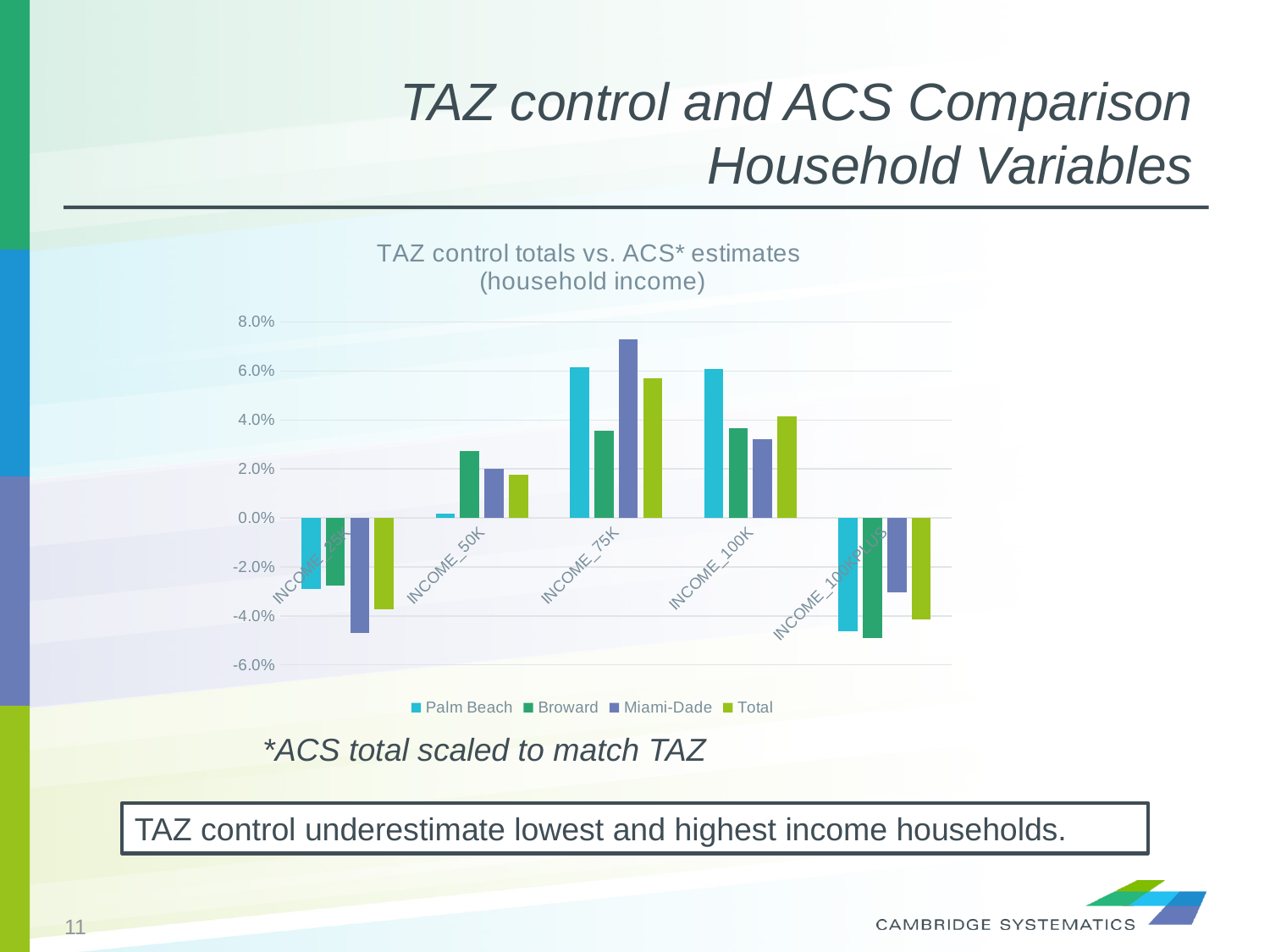
Which series is shown in light green in the legend? Total Is the Miami-Dade value for INCOME_25K greater or less than -4.0%? less What is the title of the chart? TAZ control totals vs. ACS* estimates (household income) How many series does the legend list? 4 What kind of chart is shown on the slide? Bar chart In which income category is the Miami-Dade value the lowest? INCOME_25K In the INCOME_100K category, which is larger: the Palm Beach value or the Broward value? Palm Beach How many income categories are shown on the x axis? 5 Is the Miami-Dade value for INCOME_75K greater or less than 6.0%? greater Which series has the highest value in the INCOME_75K category? Miami-Dade In which income category is the Miami-Dade value the highest? INCOME_75K Is the Broward value for INCOME_75K greater or less than 4.0%? less